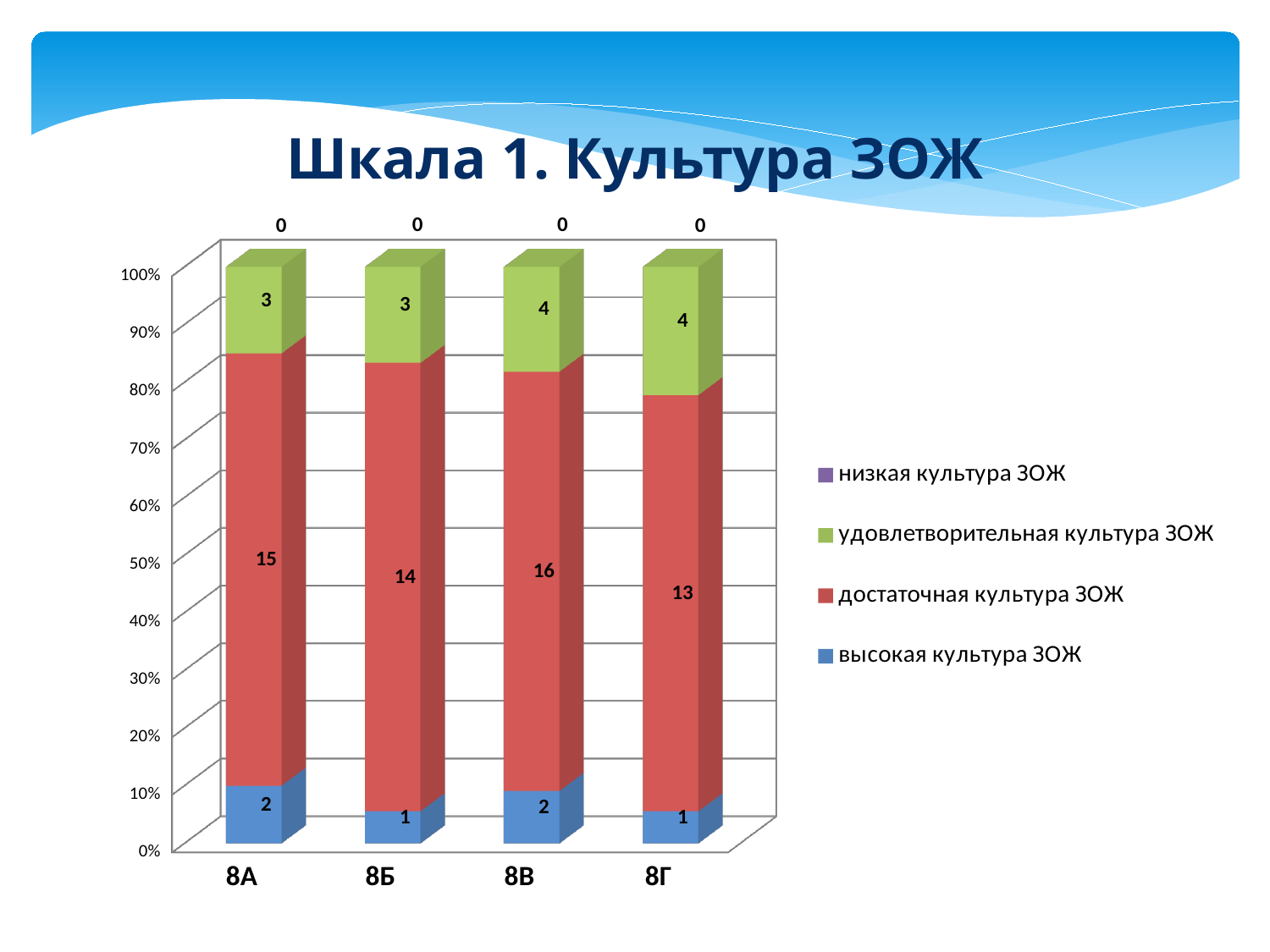
What is the value for 'высокая культура ЗОЖ' in class 8Б? 1 Which class has the lowest value for 'достаточная культура ЗОЖ'? 8Г What is the value for 'низкая культура ЗОЖ' in class 8А? 0 What is the total of all values in the bar for class 8В? 22 Which class has the highest value for 'достаточная культура ЗОЖ'? 8В What is the value for 'достаточная культура ЗОЖ' in class 8В? 16 What is the difference between the 'достаточная культура ЗОЖ' values for 8А and 8Г? 2 Which is larger: the 'высокая культура ЗОЖ' value for 8А or for 8Г? 8А What is the value for 'удовлетворительная культура ЗОЖ' in class 8Г? 4 How many series does the legend list? 4 What kind of chart is shown on the slide? Stacked bar chart How many classes are shown on the x axis? 4